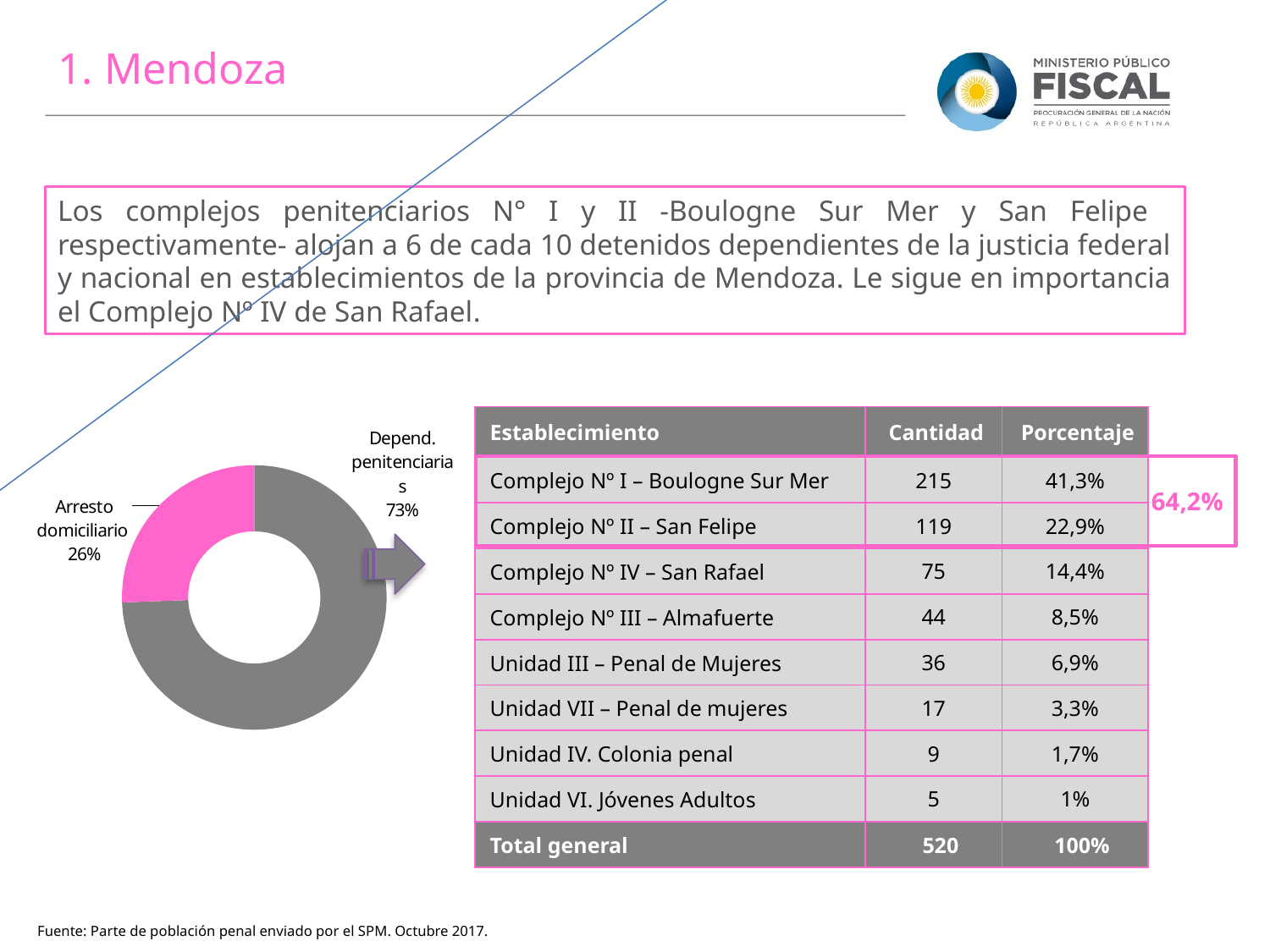
What colour is the 'Depend. penitenciarias' slice in the pie chart? grey What share of the pie chart does 'Arresto domiciliario' represent? 26% Which slice of the pie chart is the smallest? Arresto domiciliario Which is larger in the pie chart, 'Depend. penitenciarias' or 'Arresto domiciliario'? Depend. penitenciarias What colour is the 'Arresto domiciliario' slice in the pie chart? pink How many slices does the pie chart have? 2 Is the share for 'Depend. penitenciarias' in the pie chart greater or less than 50%? greater What kind of chart is shown on the left of the slide? pie chart (donut) What share of the pie chart does 'Depend. penitenciarias' represent? 73% By how many percentage points does the 'Depend. penitenciarias' share exceed the 'Arresto domiciliario' share in the pie chart? 47 percentage points Which slice of the pie chart is the largest? Depend. penitenciarias